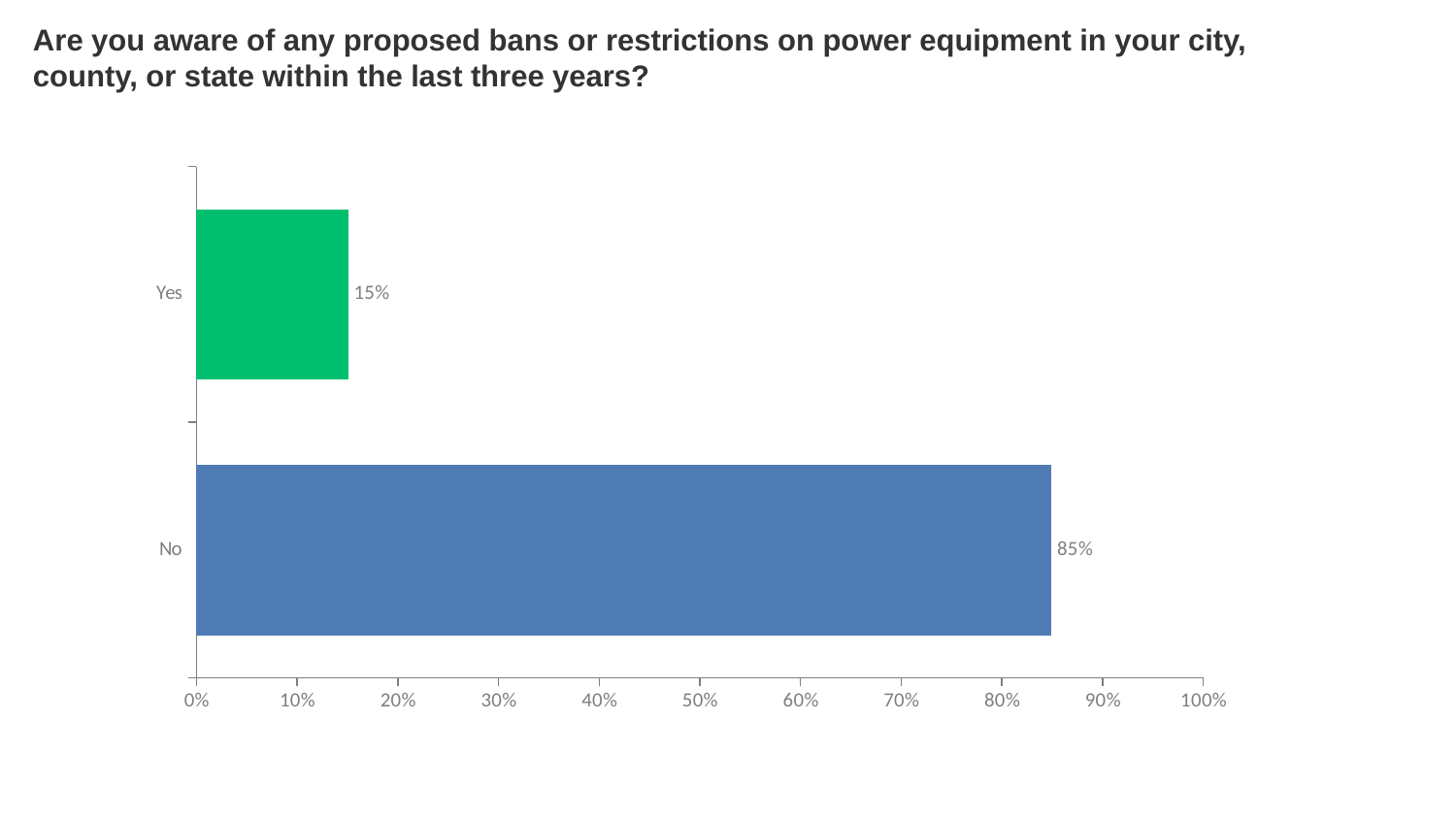
How many response categories are shown in the chart? 2 What is the total of the Yes and No percentages? 100% What is the difference between the No and Yes percentages? 70% What kind of chart is shown on the slide? Bar chart What colour is the bar for Yes? Green What percentage of respondents answered Yes? 15% Which response category has the highest value? No Which is larger, the value for Yes or the value for No? No Is the value for No greater or less than 80%? greater Is the value for Yes greater or less than 20%? less Which response category has the lowest value? Yes What percentage of respondents answered No? 85%